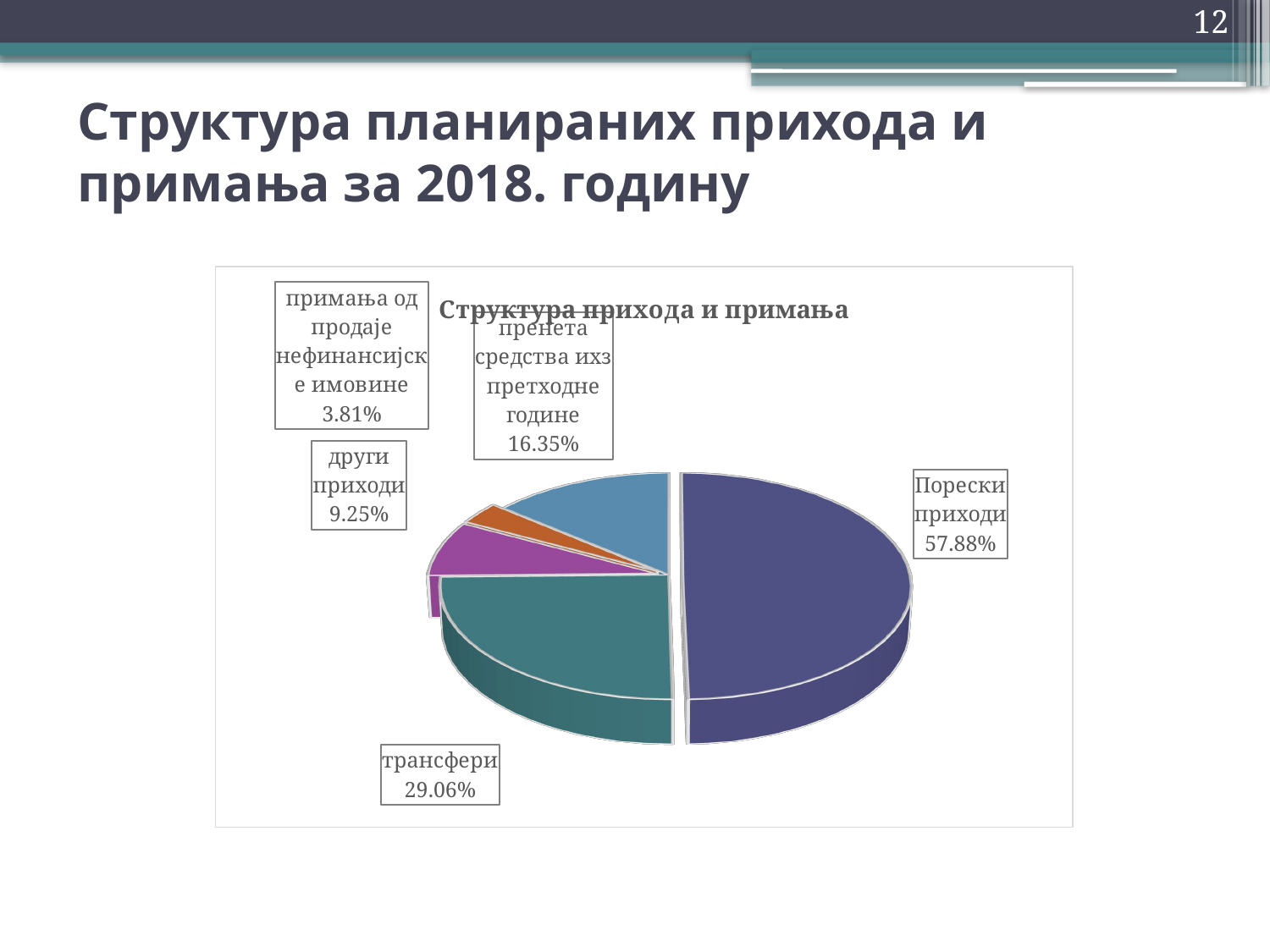
What is the value shown for примања од продаје нефинансијске имовине? 3.81% What is the value shown for пренета средства из претходне године? 16.35% What is the value shown for трансфери? 29.06% What is the value shown for други приходи? 9.25% Which category has the largest slice of the pie? Порески приходи Which is larger, трансфери or други приходи? трансфери What is the difference between the values for Порески приходи and трансфери? 28.82% How many slices does the pie chart have? 5 What kind of chart is shown on the slide? pie chart What is the title of the chart? Структура прихода и примања Which category has the smallest slice of the pie? примања од продаје нефинансијске имовине What is the value shown for Порески приходи? 57.88%